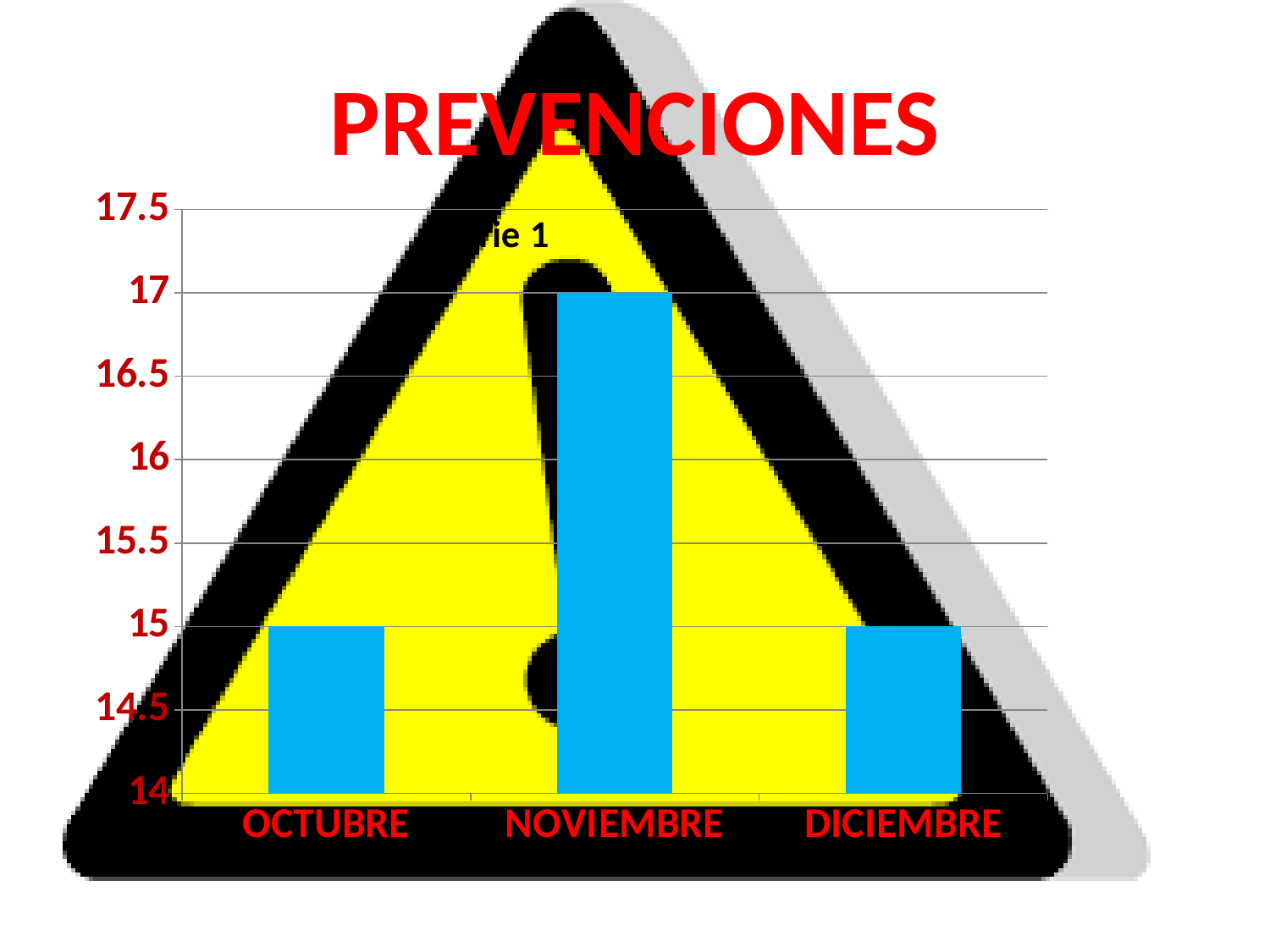
What is the value for NOVIEMBRE? 17 Which is larger, the value for NOVIEMBRE or the value for DICIEMBRE? NOVIEMBRE What is the value for DICIEMBRE? 15 What is the value for OCTUBRE? 15 Is the value for NOVIEMBRE greater or less than 16? greater What kind of chart is shown on the slide? bar chart What is the title of the slide? PREVENCIONES How many categories are shown on the x axis? 3 Is the value for OCTUBRE greater or less than 16? less What is the difference between the values for NOVIEMBRE and OCTUBRE? 2 What colour are the bars in the chart? blue Which month has the highest value? NOVIEMBRE